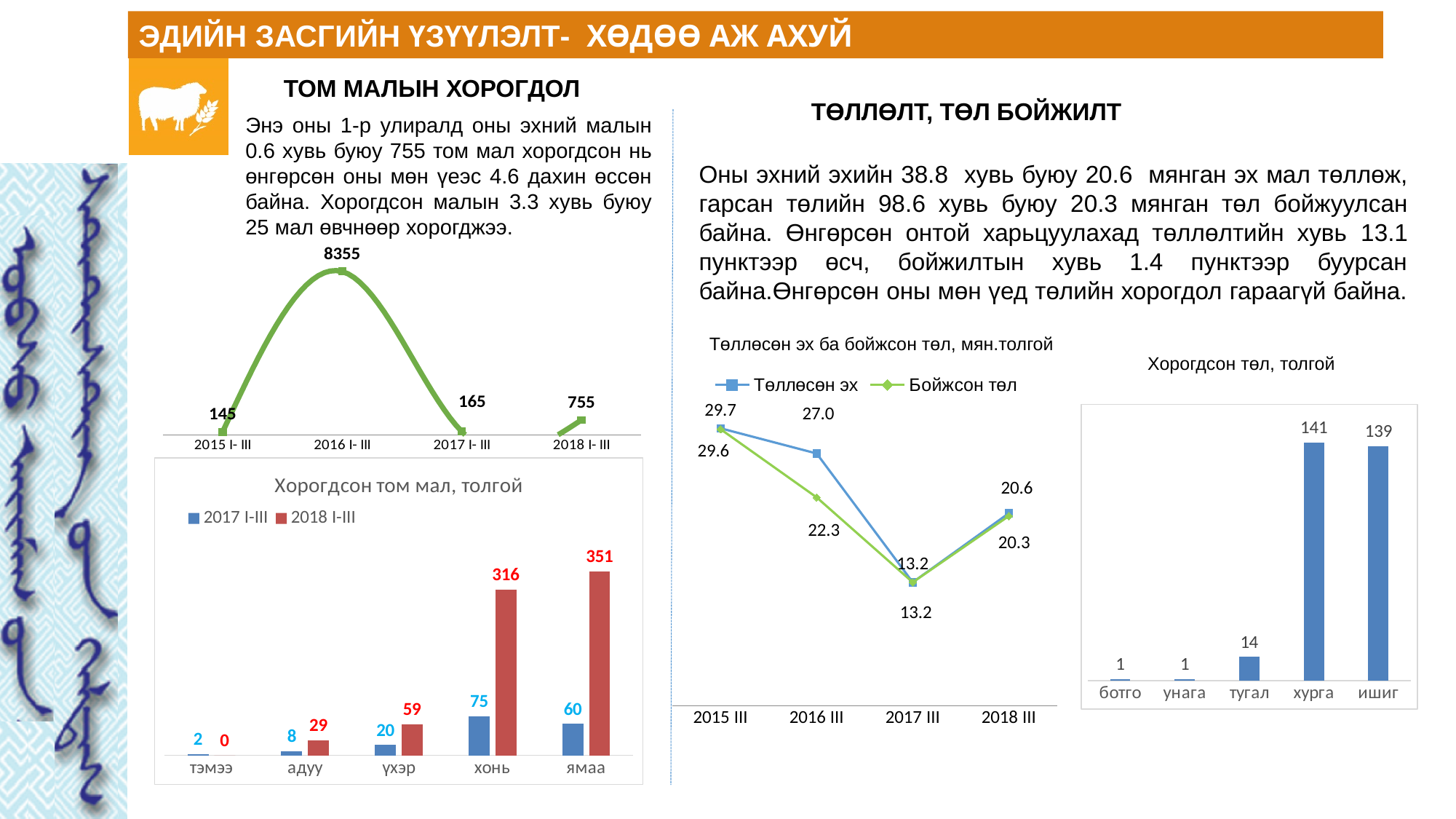
In the 'Хорогдсон төл, толгой' chart, which category has the highest value? хурга What kind of chart is 'Хорогдсон төл, толгой'? bar chart How many categories are shown in the 'Хорогдсон төл, толгой' chart? 5 In the 'Төллөсөн эх ба бойжсон төл, мян.толгой' chart, which is larger for 2016 III: Төллөсөн эх or Бойжсон төл? Төллөсөн эх In the top-left line chart under 'ТОМ МАЛЫН ХОРОГДОЛ', what is the value for 2016 I-III? 8355 In the top-left line chart under 'ТОМ МАЛЫН ХОРОГДОЛ', which period has the lowest value? 2015 I-III In the 'Хорогдсон том мал, толгой' chart, which category has the highest value in the 2018 I-III series? ямаа In the 'Төллөсөн эх ба бойжсон төл, мян.толгой' chart, what is the value of Бойжсон төл for 2016 III? 22.3 How many series does the legend of the 'Хорогдсон том мал, толгой' chart list? 2 In the 'Хорогдсон төл, толгой' chart, what is the value for тугал? 14 In the 'Хорогдсон том мал, толгой' chart, what is the difference between the 2018 I-III and 2017 I-III values for ямаа? 291 In the 'Хорогдсон том мал, толгой' chart, what is the value for хонь in the 2018 I-III series? 316